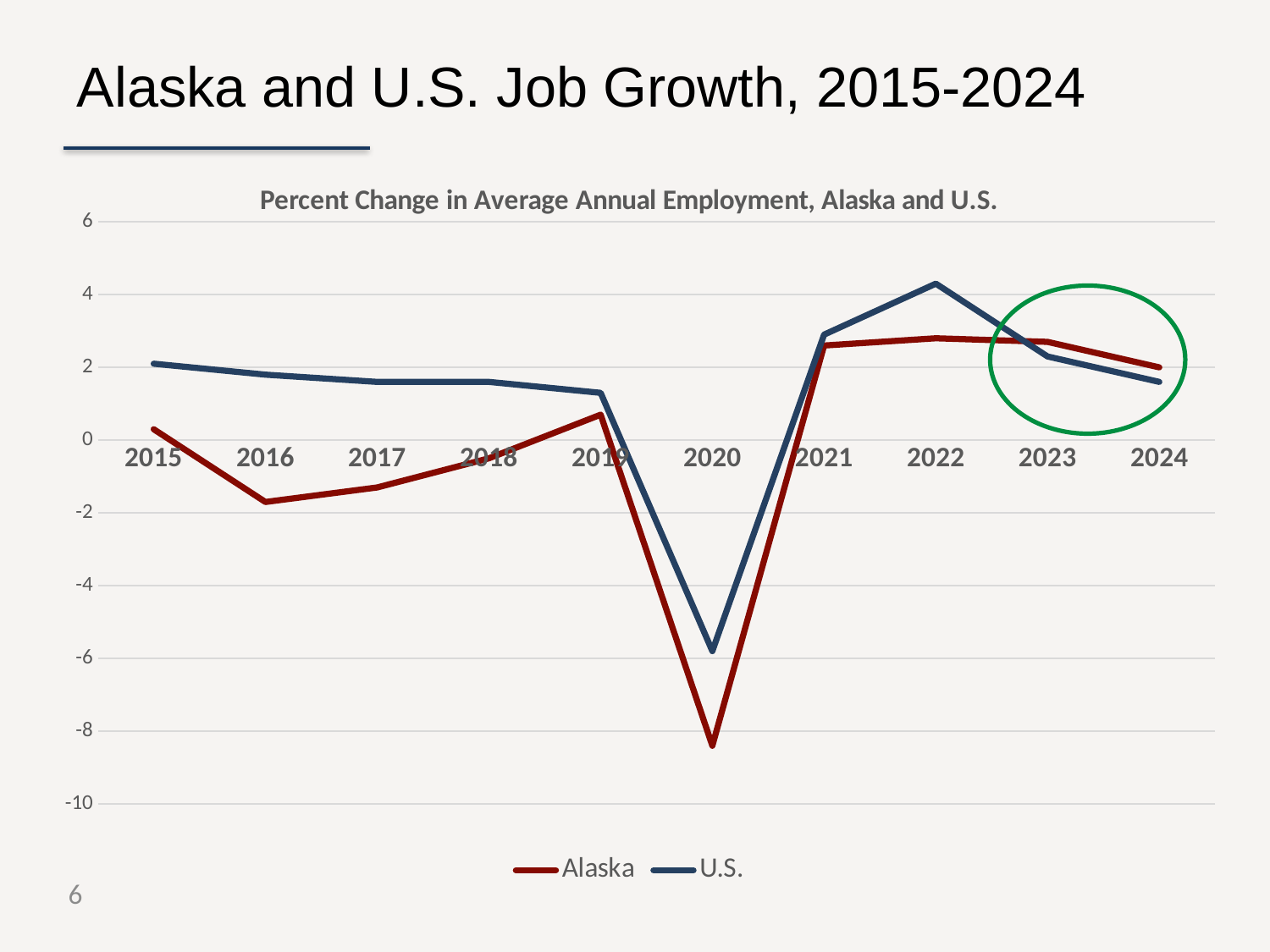
What kind of chart is shown on the slide? line chart What colour is the Alaska line in the chart? red In 2024, which series has the higher value, Alaska or U.S.? Alaska Is the Alaska value for 2020 greater or less than -6? less Which series had the larger decline in 2020, Alaska or U.S.? Alaska Is the Alaska value for 2016 greater or less than 0? less Is the U.S. value for 2022 greater or less than 4? greater In which year does the Alaska line reach its lowest value? 2020 In which year does the U.S. line reach its highest value? 2022 How many series does the legend list? 2 How many years are plotted along the x axis? 10 Does the U.S. line rise or fall from 2022 to 2024? fall